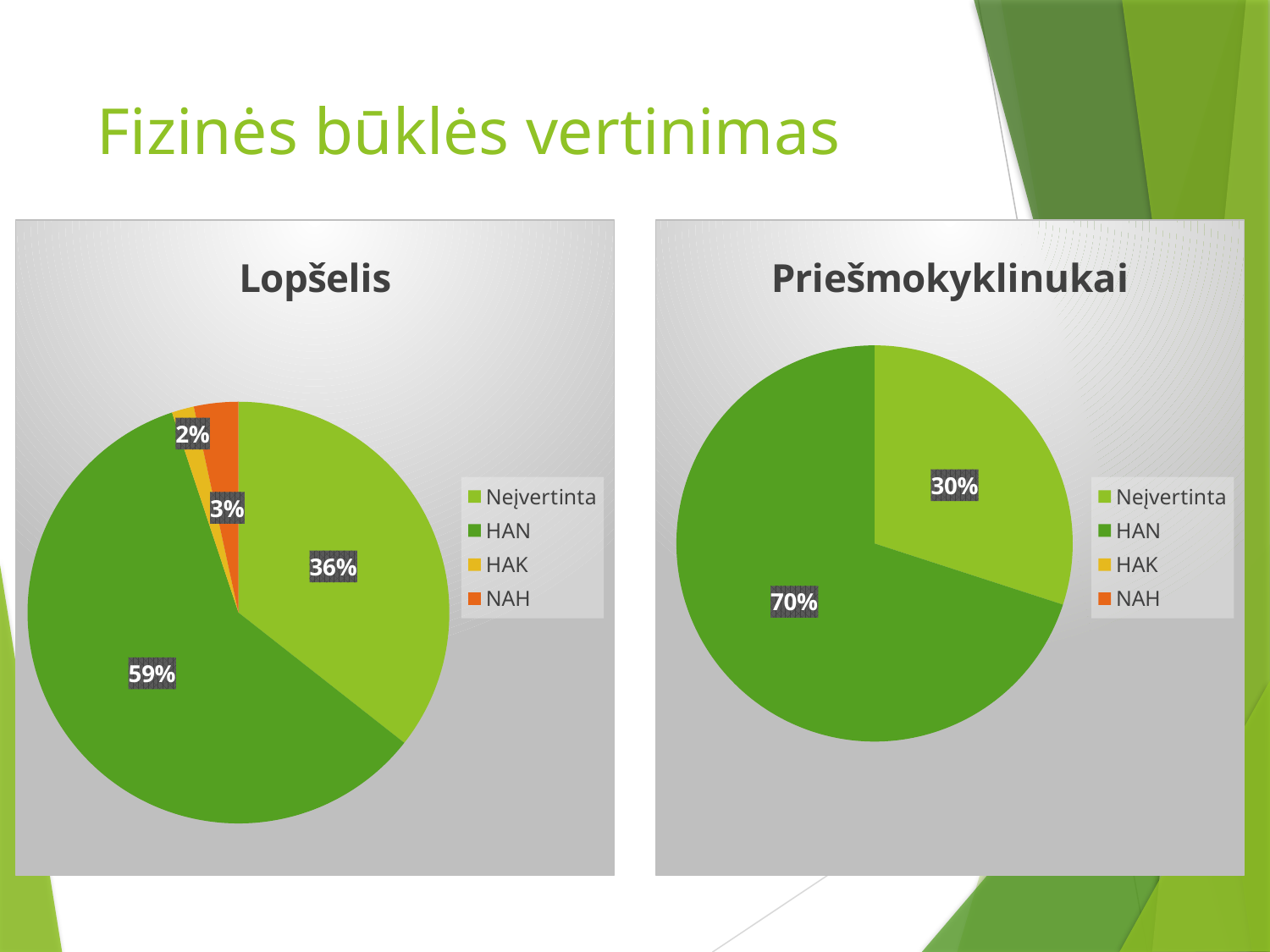
In the Priešmokyklinukai chart, what percentage is shown for HAN? 70% In the Priešmokyklinukai chart, what percentage is shown for Neįvertinta? 30% What type of chart is the Priešmokyklinukai chart? Pie chart In the Priešmokyklinukai chart, what is the difference between the HAN and Neįvertinta shares? 40% In the Lopšelis chart, what is the difference between the HAN and Neįvertinta shares? 23% In the Lopšelis chart, which is larger, the Neįvertinta slice or the HAN slice? HAN What is the title of the chart on the right side of the slide? Priešmokyklinukai How many entries does the legend of the Lopšelis chart list? 4 In the Lopšelis chart, what percentage is shown for HAN? 59% In the Lopšelis chart, what percentage is shown for Neįvertinta? 36% In the Lopšelis chart, which category has the largest slice? HAN In the Priešmokyklinukai chart, which category has the largest slice? HAN